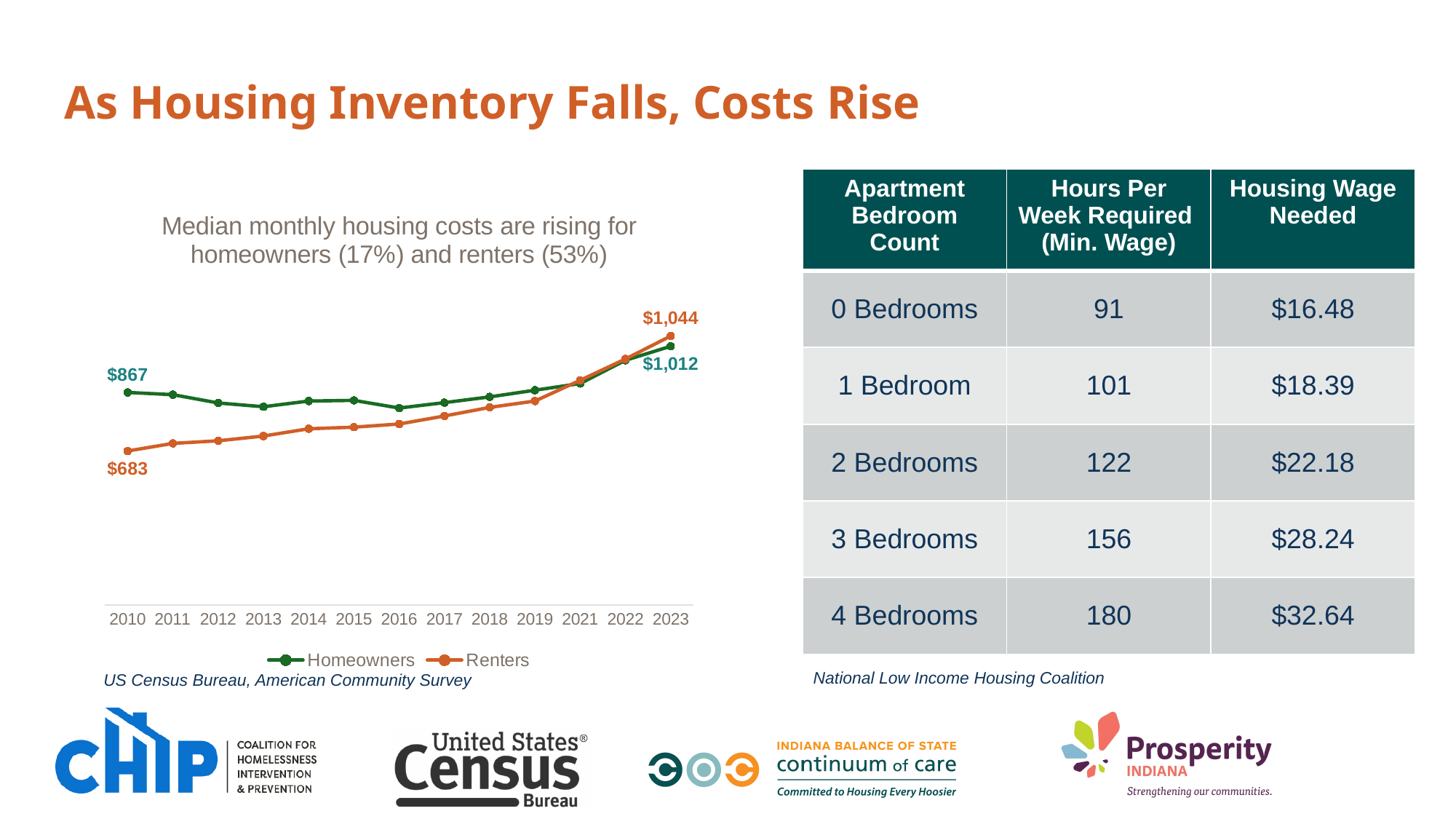
How many years are labelled on the chart's x axis? 13 What is the median monthly housing cost for Renters in 2010? $683 In 2023, which series has the higher value, Homeowners or Renters? Renters What is the median monthly housing cost for Homeowners in 2010? $867 How many series does the chart's legend list? 2 In 2010, which series has the higher value, Homeowners or Renters? Homeowners What is the median monthly housing cost for Renters in 2023? $1,044 By how much did the Homeowners value increase from 2010 to 2023? $145 Do the Renters values rise or fall from 2010 to 2023? rise By how much did the Renters value increase from 2010 to 2023? $361 What is the median monthly housing cost for Homeowners in 2023? $1,012 What kind of chart is shown on the slide? line chart